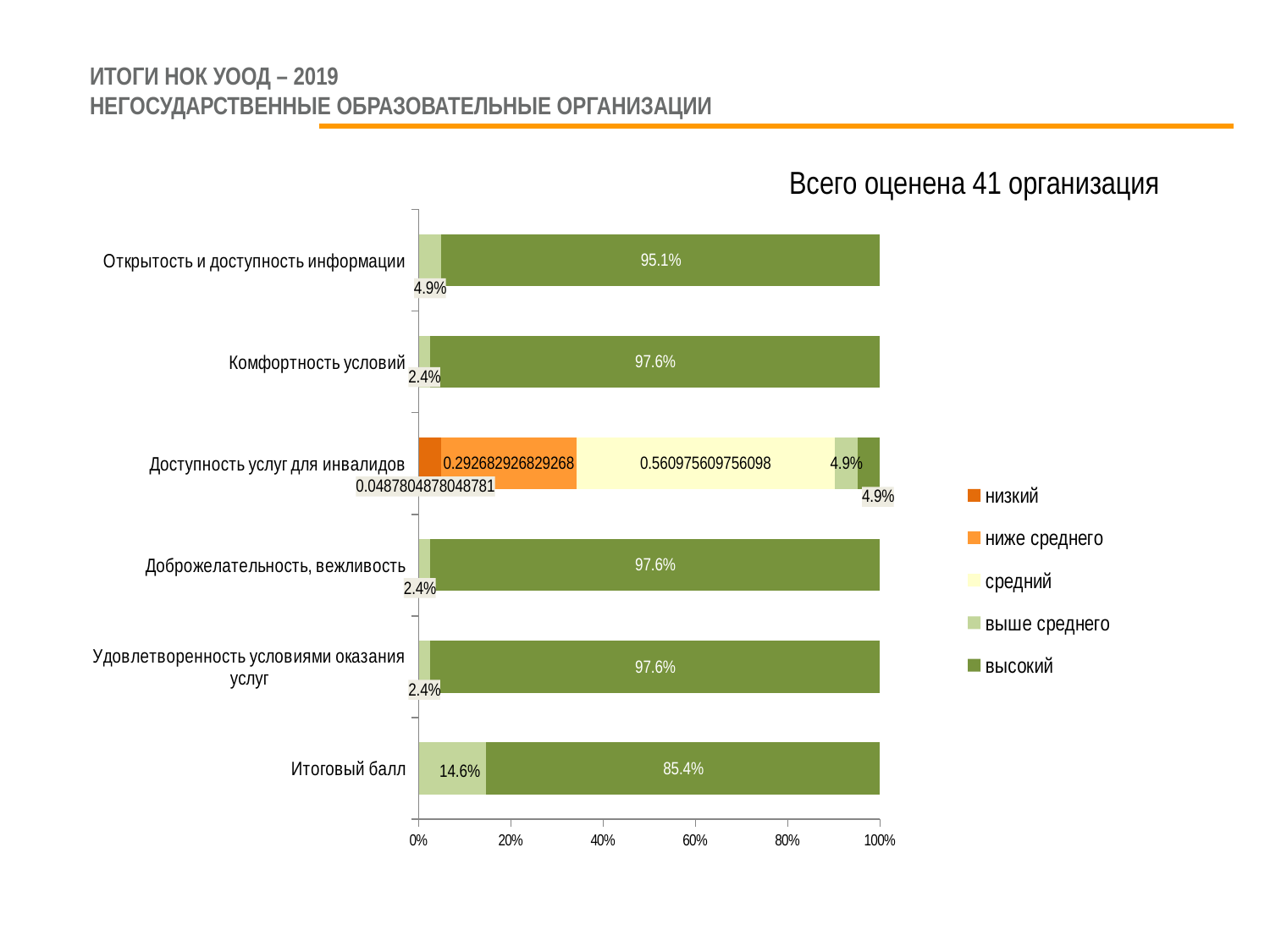
What is the value of the «высокий» series for «Комфортность условий»? 97.6% How many categories are shown on the chart? 6 What kind of chart is shown on the slide? Stacked bar chart What is the value of the «средний» series for «Доступность услуг для инвалидов»? 0.560975609756098 What is the value of the «высокий» series for «Открытость и доступность информации»? 95.1% How many series does the legend list? 5 What is the difference between the «высокий» value for «Открытость и доступность информации» and the «высокий» value for «Итоговый балл»? 9.7% Which category has the lowest value for the «высокий» series? Доступность услуг для инвалидов What is the value of the «выше среднего» series for «Итоговый балл»? 14.6% What is the value of the «ниже среднего» series for «Доступность услуг для инвалидов»? 0.292682926829268 Is the «средний» value for «Доступность услуг для инвалидов» greater or less than 40%? greater Which has the larger «выше среднего» value: «Итоговый балл» or «Открытость и доступность информации»? Итоговый балл